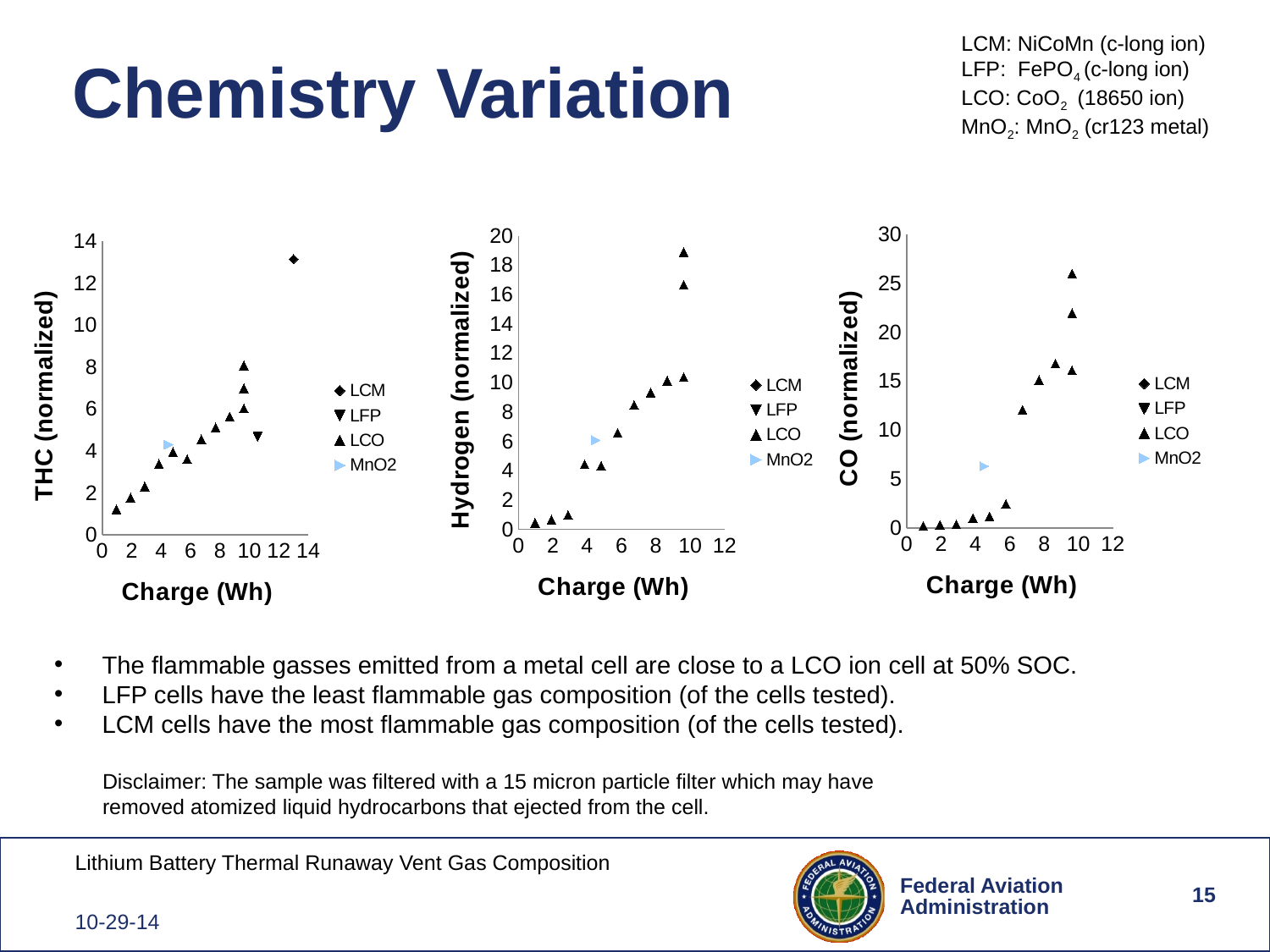
How many series does the legend of the Hydrogen (normalized) chart list? 4 In the THC (normalized) chart, is the value of the LFP point greater or less than 6? less In the THC (normalized) chart, which series has the highest plotted value? LCM What is the x-axis title of the CO (normalized) chart? Charge (Wh) What is the y-axis title of the middle chart? Hydrogen (normalized) How many charts are shown on the slide? 3 In the Hydrogen (normalized) chart, is the value of the MnO2 point greater or less than 5? greater In the THC (normalized) chart, is the value of the LCM point greater or less than 12? greater What kind of chart is the THC (normalized) chart on the left? scatter chart In the Hydrogen (normalized) chart, do the LCO values rise or fall as charge increases? rise